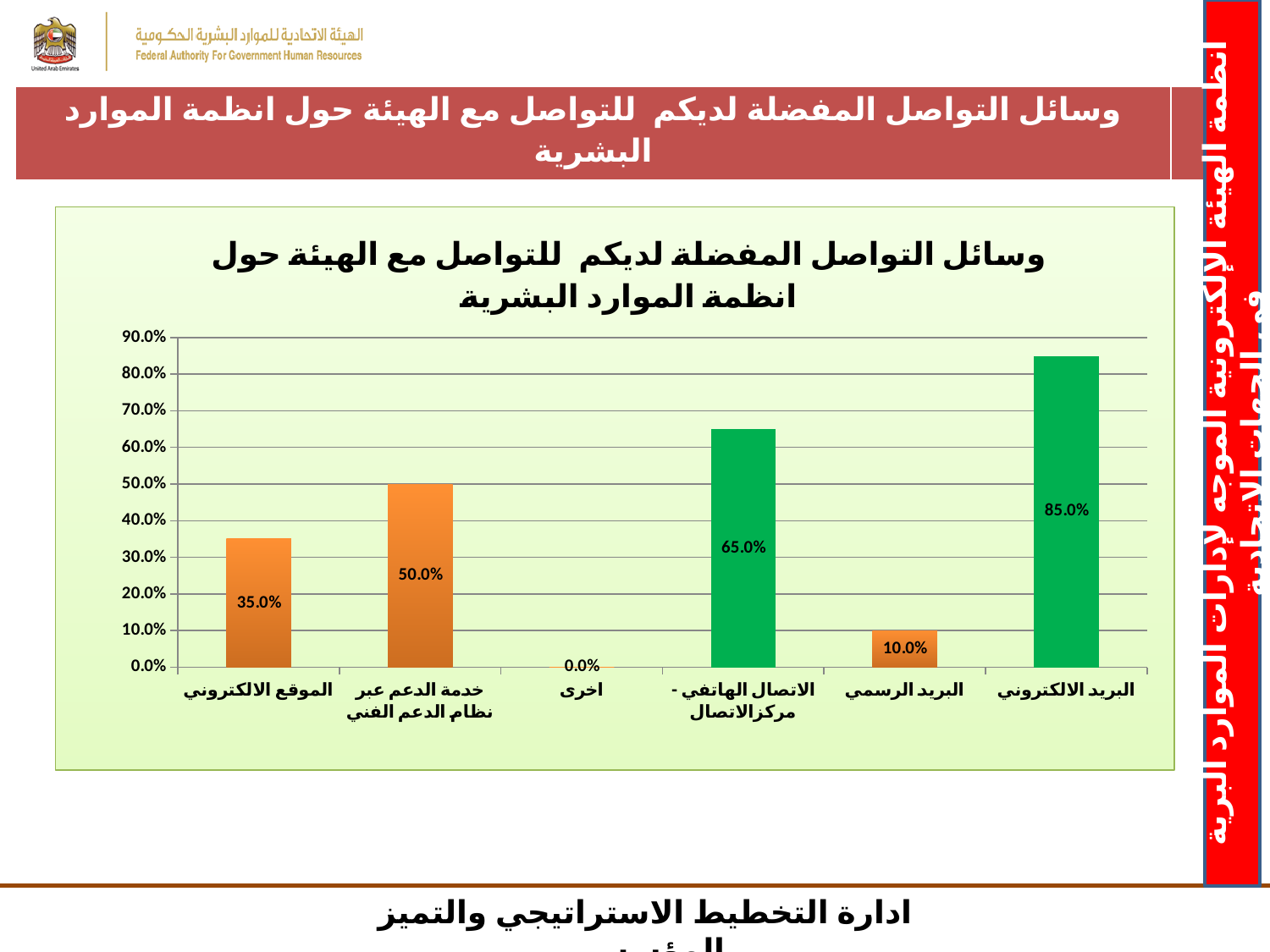
What is the value for خدمة الدعم عبر نظام الدعم الفني? 50.0% What kind of chart is shown on the slide? Bar chart How many categories are shown on the x axis? 6 Which category has the highest value? البريد الالكتروني What is the value for البريد الرسمي? 10.0% What is the value for الموقع الالكتروني? 35.0% Which is larger, the value for خدمة الدعم عبر نظام الدعم الفني or the value for الموقع الالكتروني? خدمة الدعم عبر نظام الدعم الفني What is the value for الاتصال الهاتفي - مركزالاتصال? 65.0% What is the value for البريد الالكتروني? 85.0% What is the difference between the values for البريد الالكتروني and الاتصال الهاتفي - مركزالاتصال? 20.0% What is the title of the chart? وسائل التواصل المفضلة لديكم للتواصل مع الهيئة حول انظمة الموارد البشرية Which category has the lowest value? اخرى